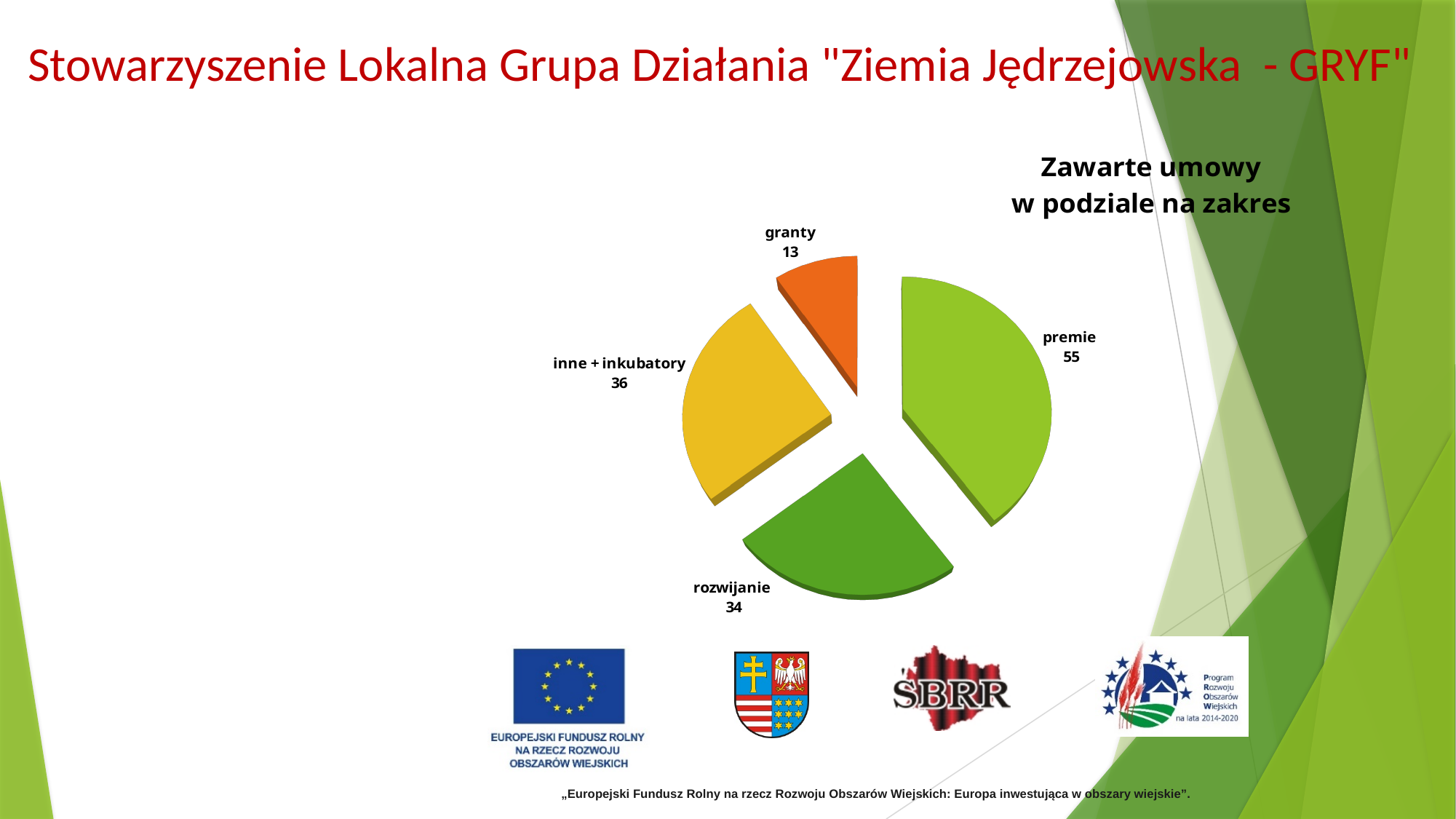
What is the value for premie? 55 Which category has the largest slice? premie Which is larger, inne + inkubatory or rozwijanie? inne + inkubatory What is the value for inne + inkubatory? 36 Which category has the smallest slice? granty How many slices does the pie chart have? 4 What is the value for rozwijanie? 34 What type of chart is shown on the slide? pie chart What is the total of all slices in the pie chart? 138 What is the title of the chart? Zawarte umowy w podziale na zakres What is the value for granty? 13 What is the difference between the values for premie and rozwijanie? 21